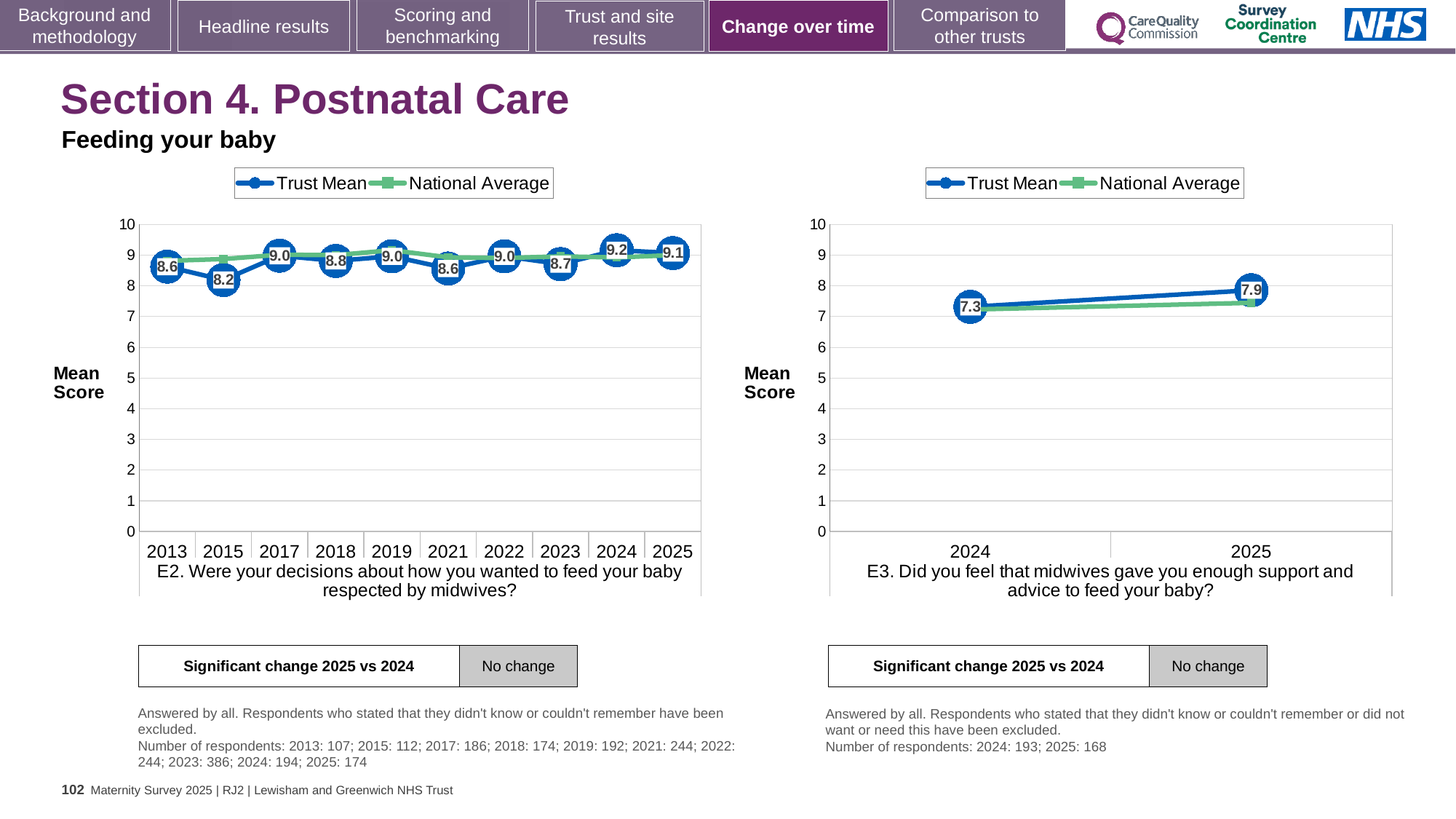
How many years are plotted on the x axis of the left chart (E2)? 10 In the left chart (E2), which year has the highest Trust Mean score? 2024 In the left chart (E2), is the Trust Mean score higher in 2017 or in 2018? 2017 How many series does the legend of the right chart (E3) list? 2 In the left chart (E2), what is the Trust Mean score for 2025? 9.1 In the left chart (E2), is the National Average value for 2025 greater or less than 8? greater In the left chart (E2), which year has the lowest Trust Mean score? 2015 In the right chart (E3), does the Trust Mean rise or fall from 2024 to 2025? Rise In the right chart (E3), what is the Trust Mean score for 2024? 7.3 What kind of chart is the right chart (E3)? Line chart In the right chart (E3), what is the difference between the Trust Mean scores for 2025 and 2024? 0.6 In the left chart (E2), what is the Trust Mean score for 2015? 8.2